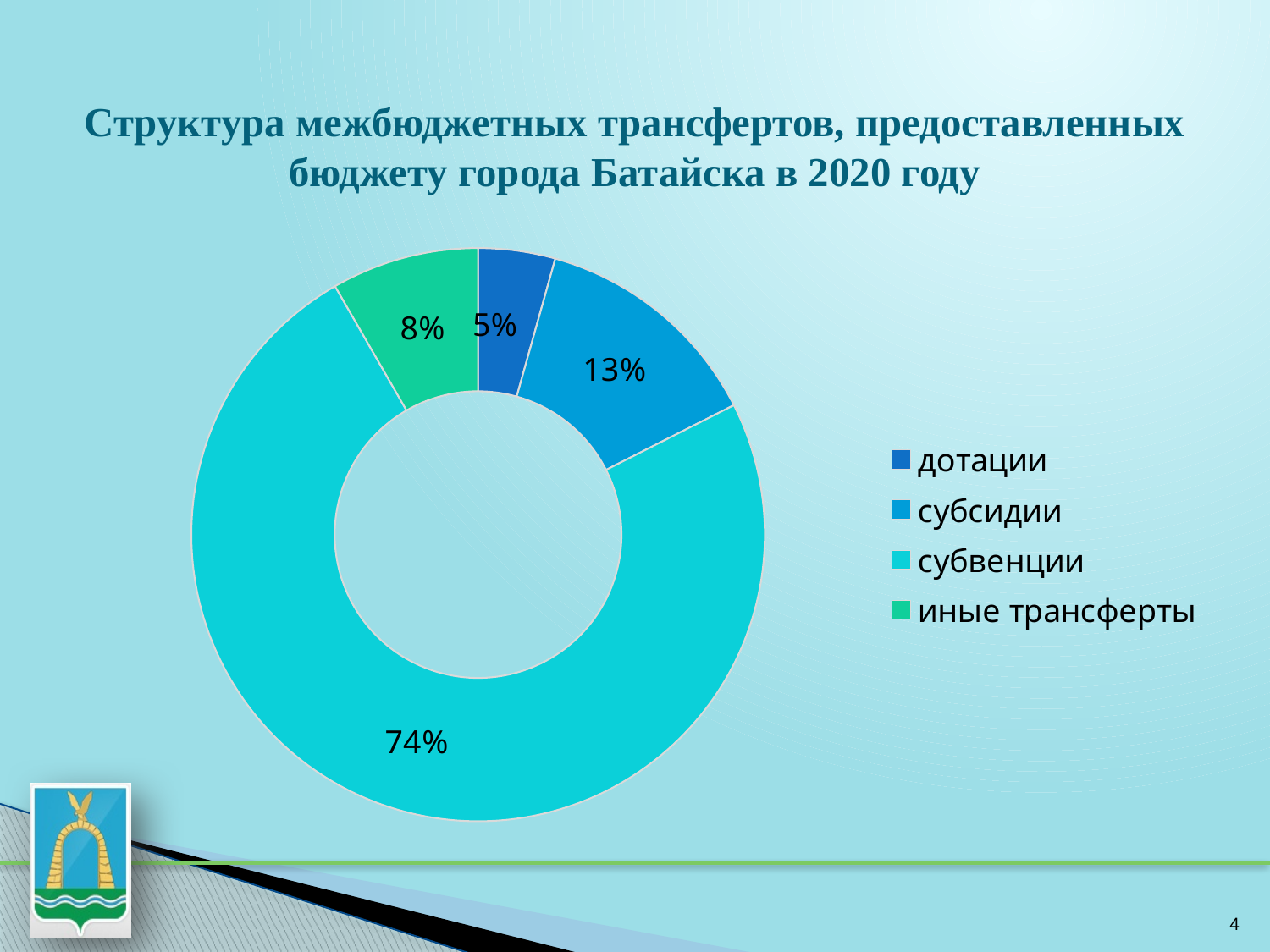
What is the difference in percentage points between субвенции and субсидии? 61 What percentage is shown for субсидии? 13% What kind of chart is shown on the slide? doughnut (pie) chart How many entries does the legend list? 4 What percentage is shown for дотации? 5% What percentage is shown for иные трансферты? 8% How many categories are shown in the chart? 4 Which category has the smallest share of the chart? дотации Which category has the largest share of the chart? субвенции What share of the chart does субвенции account for? 74% Which is larger, the share for субсидии or the share for иные трансферты? субсидии What is the combined share of дотации and иные трансферты? 13%